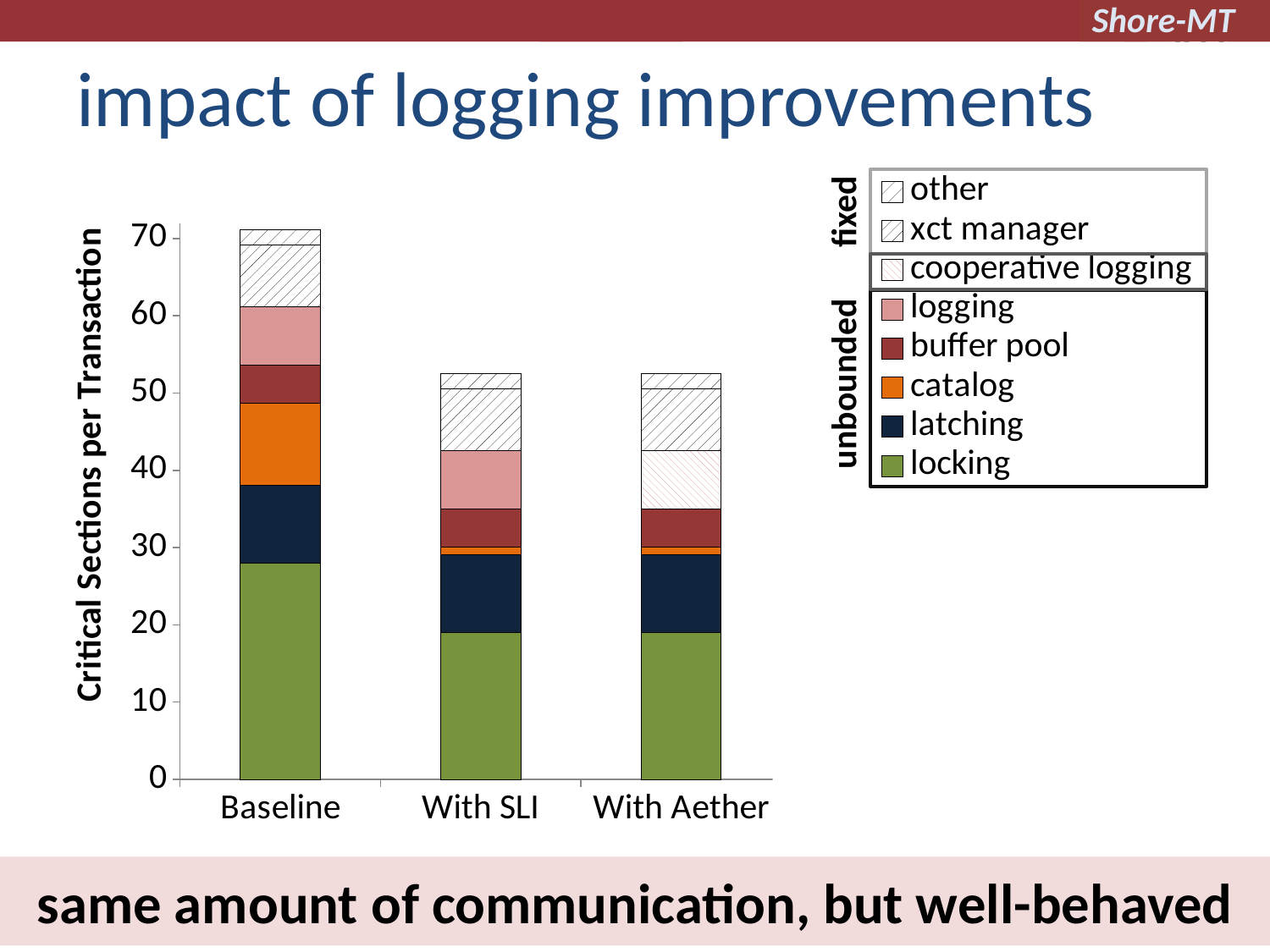
Is the locking segment for Baseline greater or less than 30? less Which legend entry is shown in green? locking How many categories are shown on the x axis of the chart? 3 Which has a larger total stacked bar, Baseline or With SLI? Baseline Is the total stacked bar for Baseline greater or less than 60? greater Which category has the tallest stacked bar? Baseline What is the label on the y axis of the chart? Critical Sections per Transaction What kind of chart is shown on the slide? stacked bar chart Is the locking segment for With SLI greater or less than 30? less How many series does the chart's legend list? 8